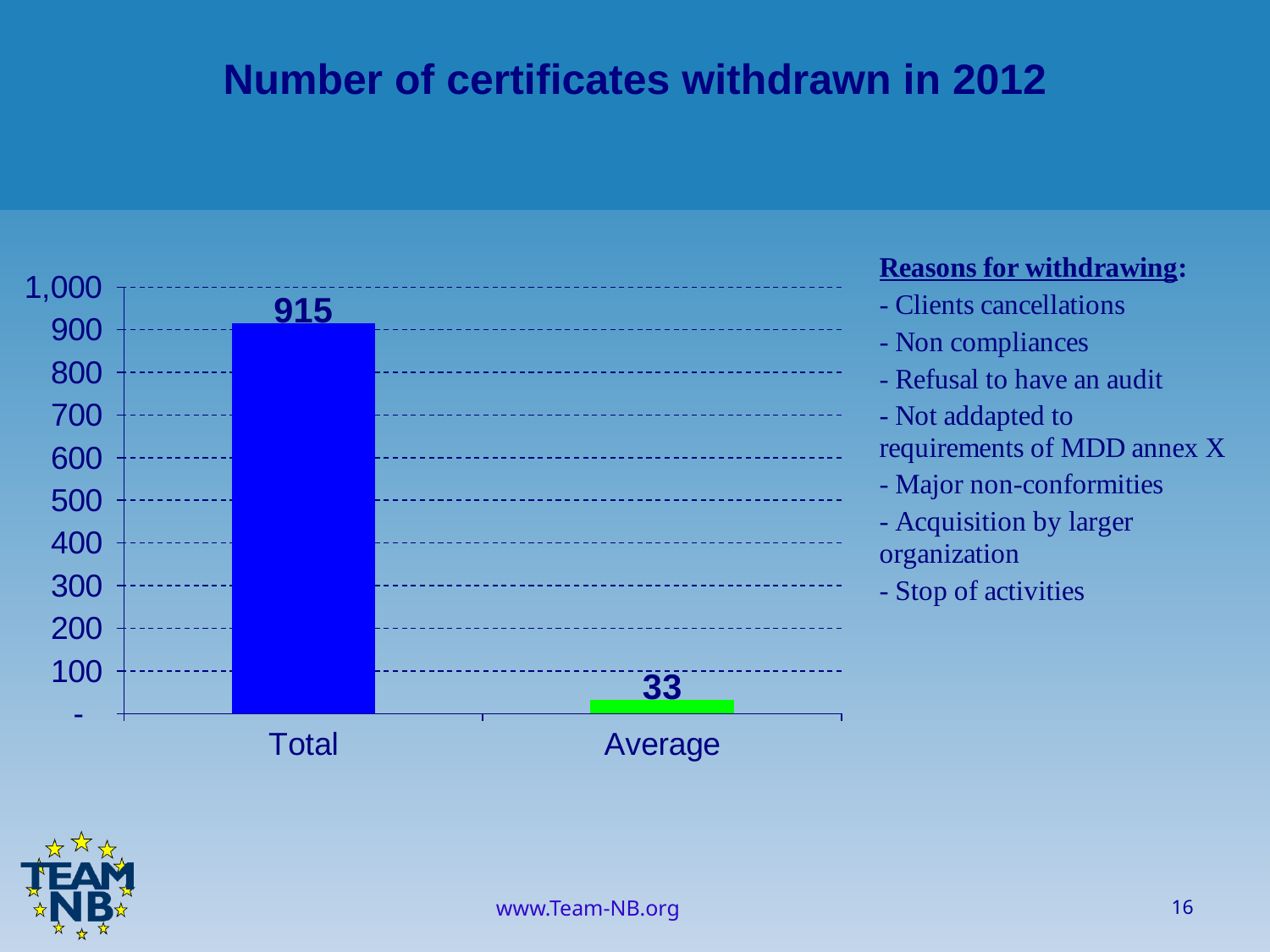
Is the value for Average greater or less than 100? less How many categories are shown on the x axis? 2 What colour is the bar for Average? green What kind of chart is shown on the slide? bar chart What is the value for Average? 33 Which category has the lowest value? Average What is the value for Total? 915 What is the title of the slide? Number of certificates withdrawn in 2012 Is the value for Total greater or less than 900? greater What is the difference between the Total and Average values? 882 Which is larger, the value for Total or the value for Average? Total Which category has the highest value? Total